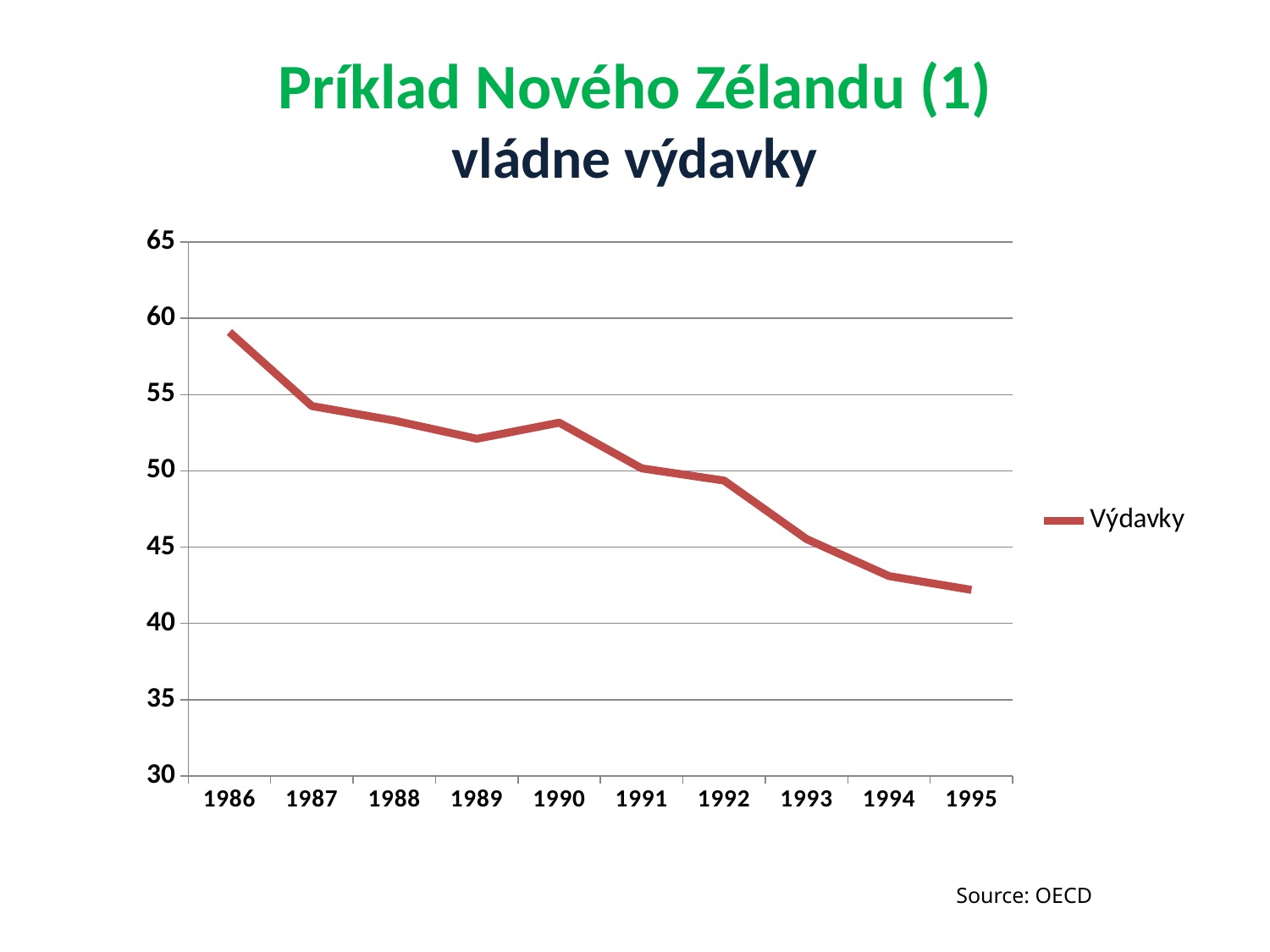
How many years are plotted on the x axis of the chart? 10 What kind of chart is shown on the slide? line chart What source is cited for the chart's data? OECD Which is larger, the value for 1990 or the value for 1989? 1990 Which year has the highest value on the chart? 1986 Do the values generally rise or fall from 1986 to 1995? fall Is the value for 1995 greater or less than 45? less Is the value for 1986 greater or less than 55? greater What is the name of the series shown in the legend? Výdavky How many series does the chart's legend list? 1 Is the value for 1989 greater or less than 50? greater Which year has the lowest value on the chart? 1995